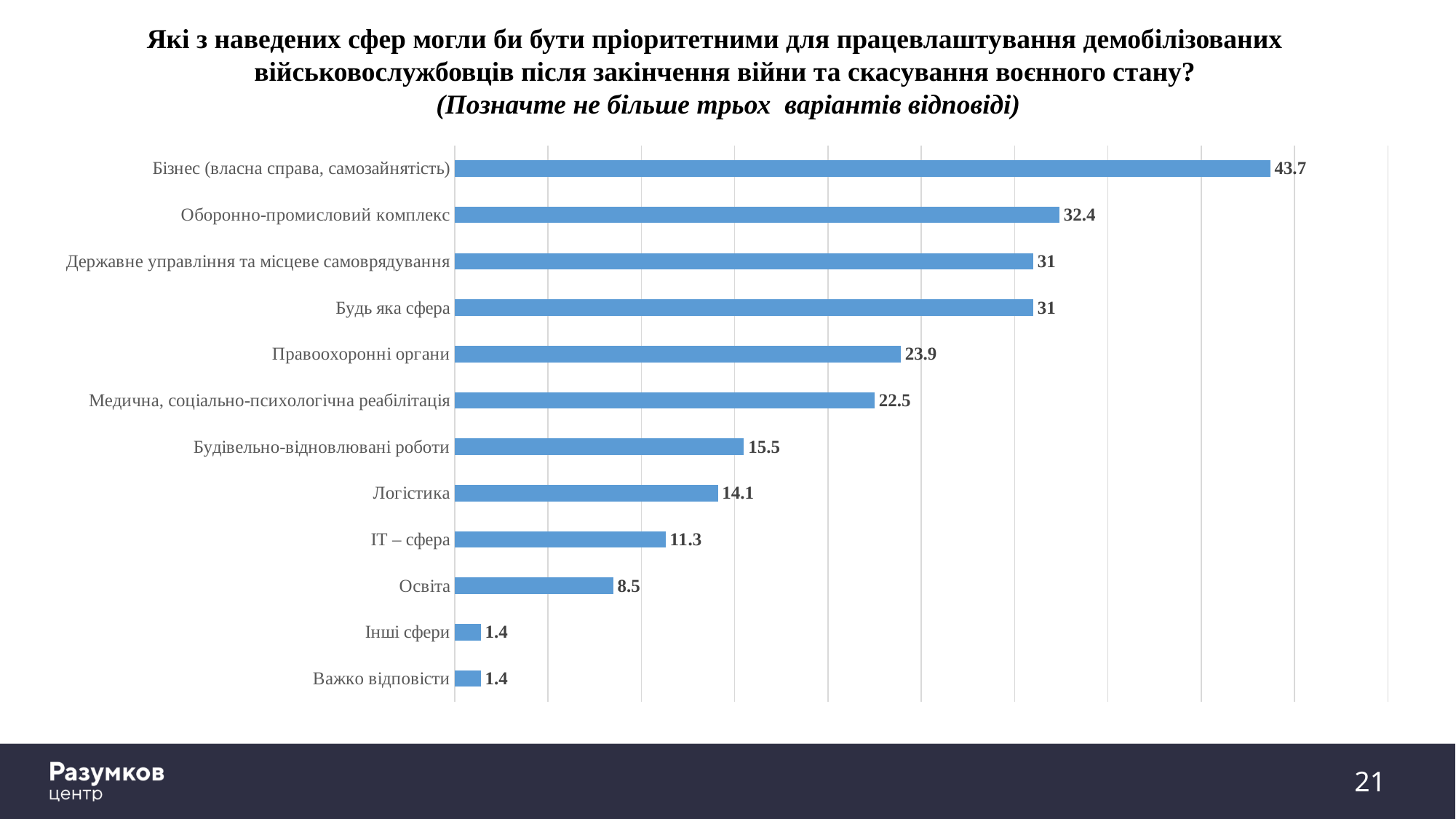
What is the difference between the values for "Будівельно-відновлювані роботи" and "Логістика"? 1.4 Which category has the highest value? Бізнес (власна справа, самозайнятість) Which two categories share the value 31? Державне управління та місцеве самоврядування; Будь яка сфера What value is shown for "Бізнес (власна справа, самозайнятість)"? 43.7 What value is shown for "Оборонно-промисловий комплекс"? 32.4 What is the lowest value shown on the chart? 1.4 What kind of chart is shown on the slide? Bar chart What value is shown for "Освіта"? 8.5 Which is larger, the value for "Медична, соціально-психологічна реабілітація" or the value for "Будівельно-відновлювані роботи"? Медична, соціально-психологічна реабілітація What is the difference between the values for "Бізнес (власна справа, самозайнятість)" and "Оборонно-промисловий комплекс"? 11.3 How many categories are shown on the chart? 12 What value is shown for "Правоохоронні органи"? 23.9